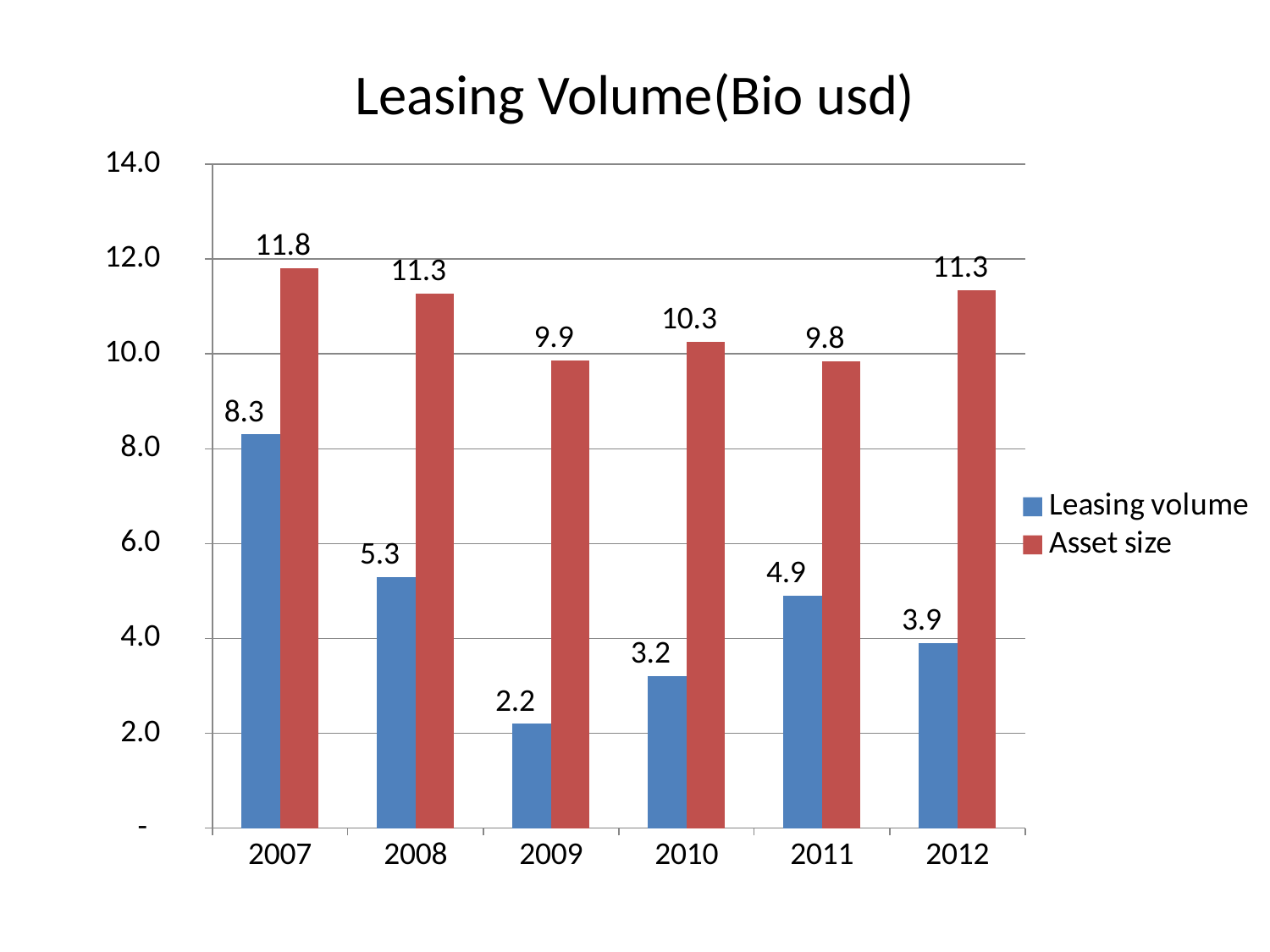
What is the Leasing volume for 2007? 8.3 What is the difference between the Asset size and the Leasing volume in 2009? 7.7 What is the title of the chart? Leasing Volume(Bio usd) Is the Asset size for 2011 greater or less than 10.0? less What kind of chart is shown on the slide? bar chart Which is larger, the Leasing volume in 2011 or the Leasing volume in 2012? 2011 How many years are shown on the x axis? 6 What is the Leasing volume for 2012? 3.9 What is the Asset size for 2010? 10.3 Which year has the lowest Leasing volume? 2009 Which year has the highest Asset size? 2007 How many series does the legend list? 2